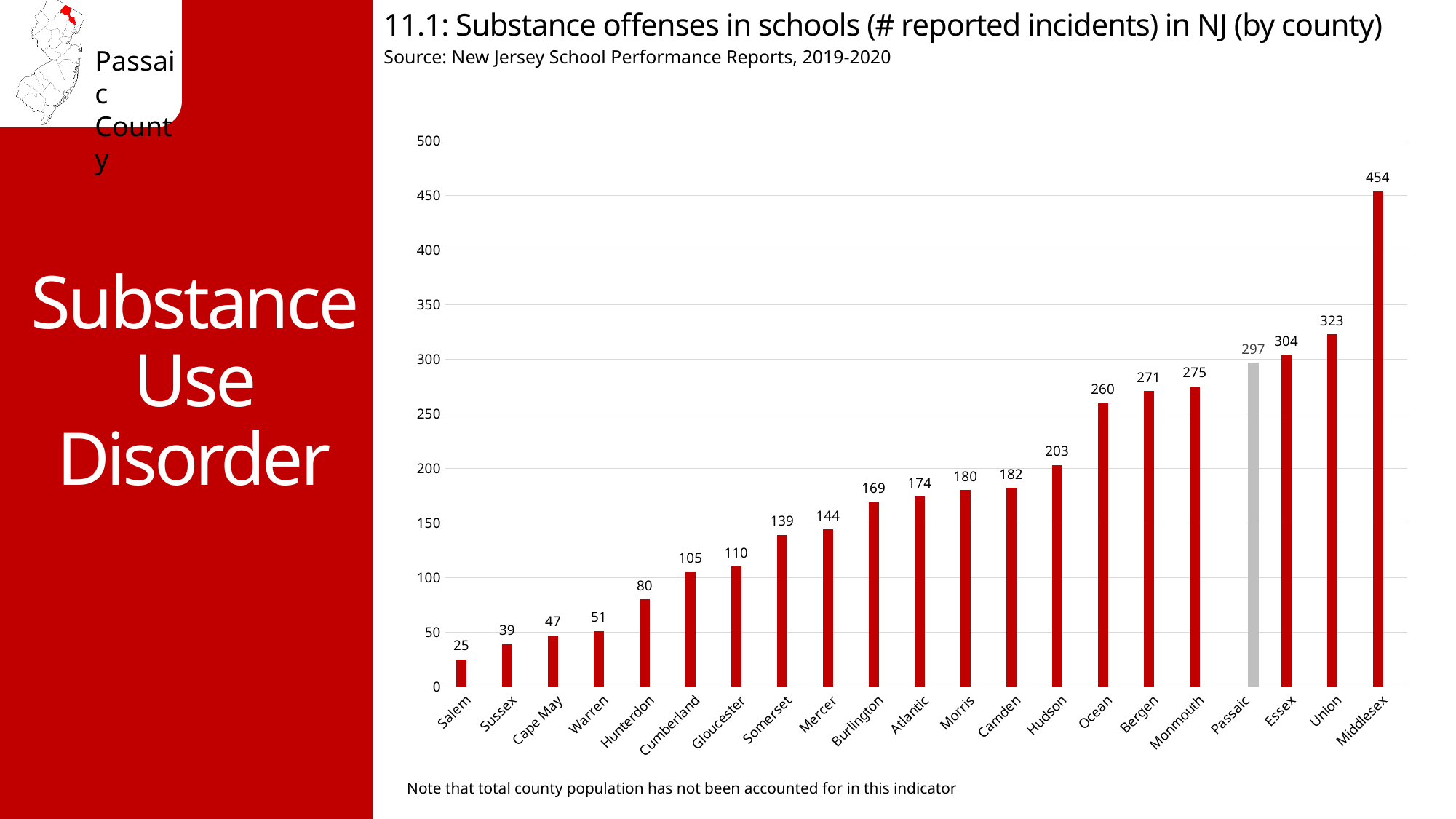
What is the difference between the values for Passaic and Monmouth? 22 Which county has the lowest number of reported incidents? Salem Do the values rise or fall moving from left to right along the x axis? Rise How many counties are shown on the x axis? 21 What kind of chart is this? Bar chart What is the value shown for Cape May? 47 Which county's bar is coloured grey instead of red? Passaic What is the difference between the values for Middlesex and Union? 131 Which has a higher value, Bergen or Ocean? Bergen Which county has the highest number of reported incidents? Middlesex What is the value shown for Hudson? 203 How many reported substance offense incidents in schools does the chart show for Passaic? 297